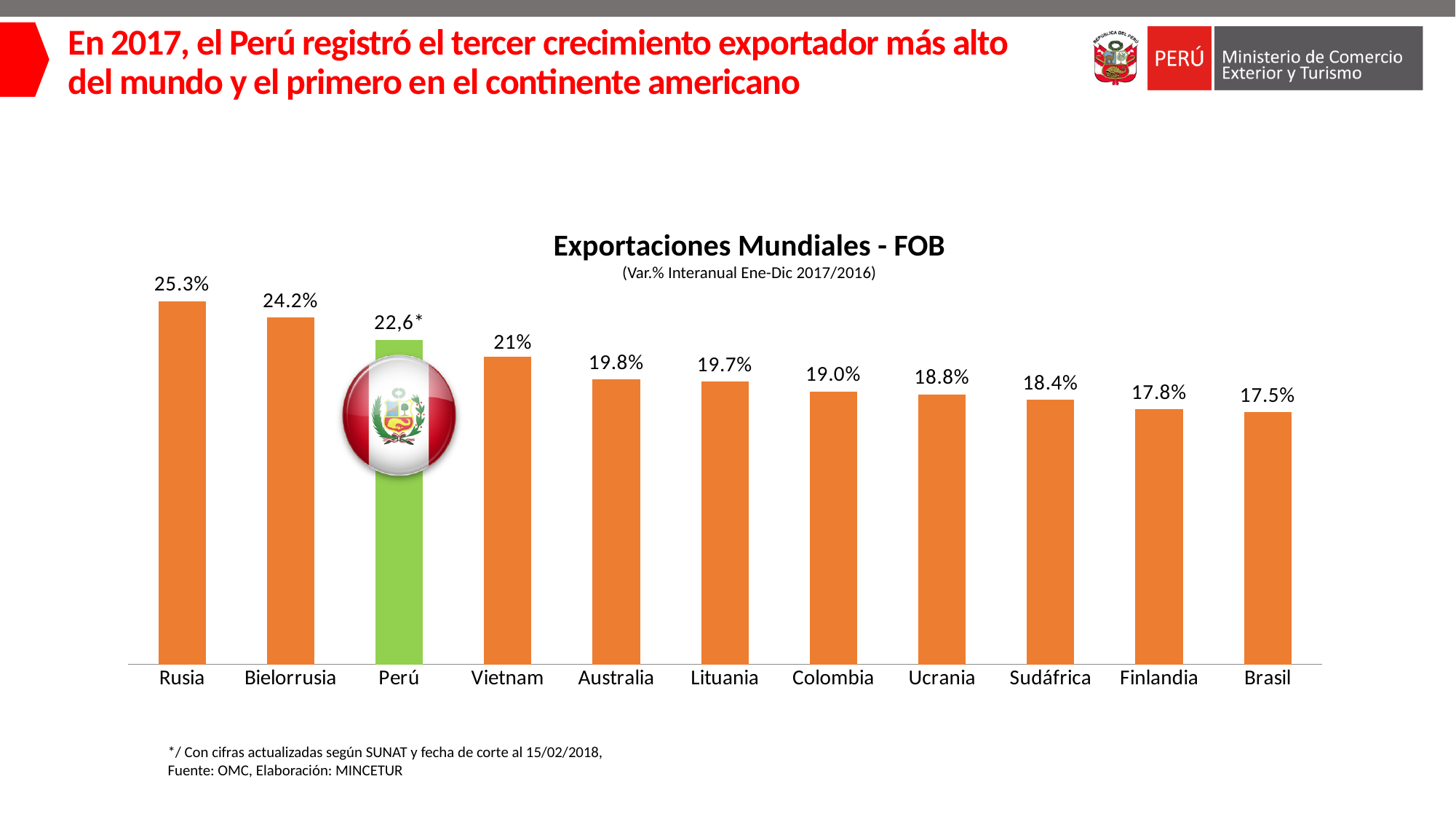
Which bar in the chart is coloured green instead of orange? Perú How many countries are shown in the chart? 11 Which has a larger value, Australia or Sudáfrica? Australia What is the difference between the values for Vietnam and Finlandia? 3.2% Which country has the highest value in the chart? Rusia Which country has the lowest value in the chart? Brasil What is the difference between the values for Rusia and Bielorrusia? 1.1% What is the value shown for Perú? 22,6* What is the value shown for Colombia? 19.0% What is the value shown for Rusia? 25.3% What is the value shown for Brasil? 17.5% What kind of chart is shown on the slide? Bar chart